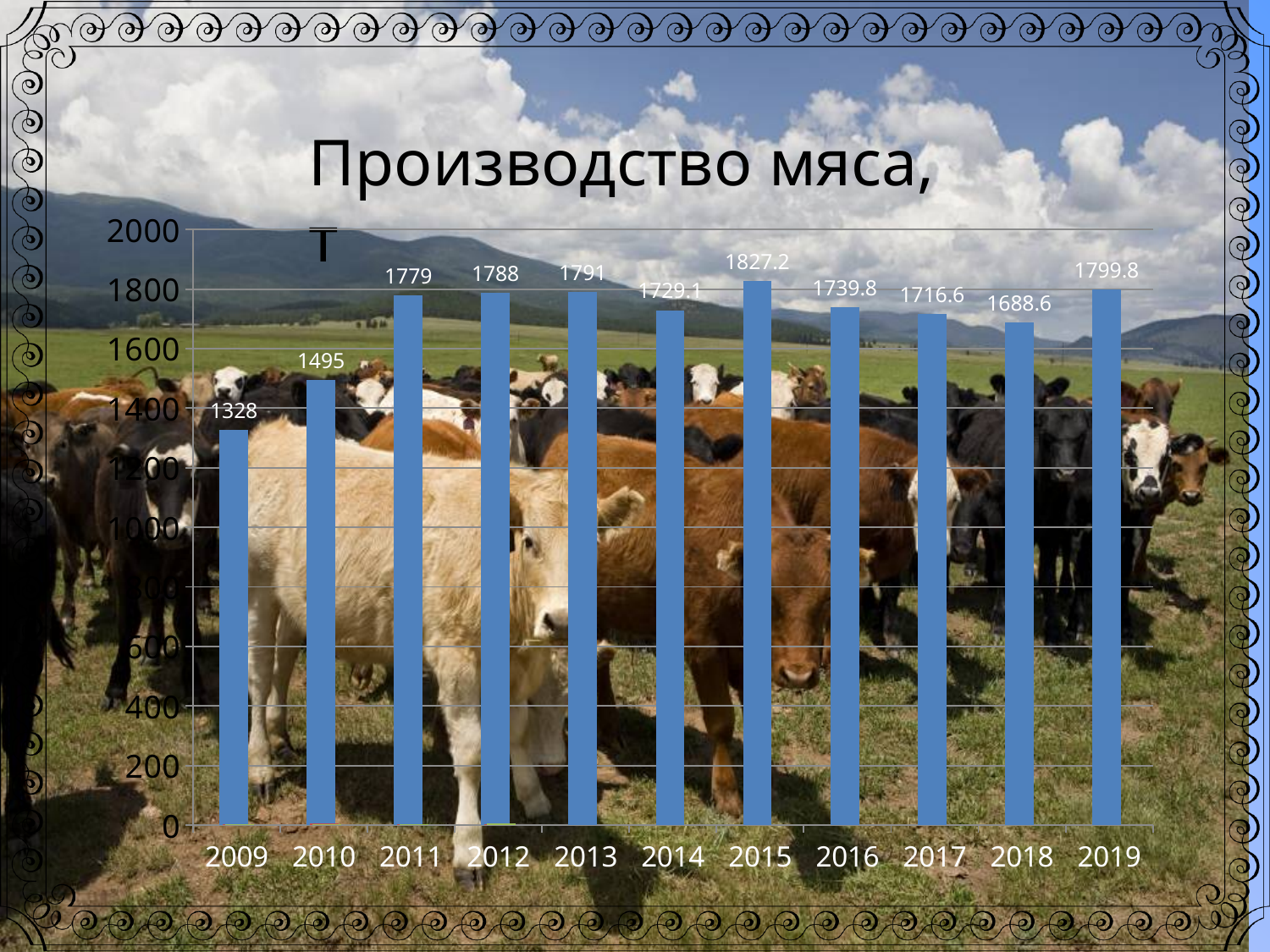
What is the difference between the values for 2015 and 2019? 27.4 What is the difference between the values for 2010 and 2009? 167 What is the value for 2018? 1688.6 Which year has the lowest value? 2009 What is the value for 2009? 1328 How many years are shown on the x axis? 11 Which year has the highest value? 2015 Is the value for 2010 greater or less than 1600? less What is the value for 2015? 1827.2 What kind of chart is shown on the slide? bar chart Which is larger, the value for 2014 or the value for 2016? 2016 What is the title of the chart? Производство мяса, т